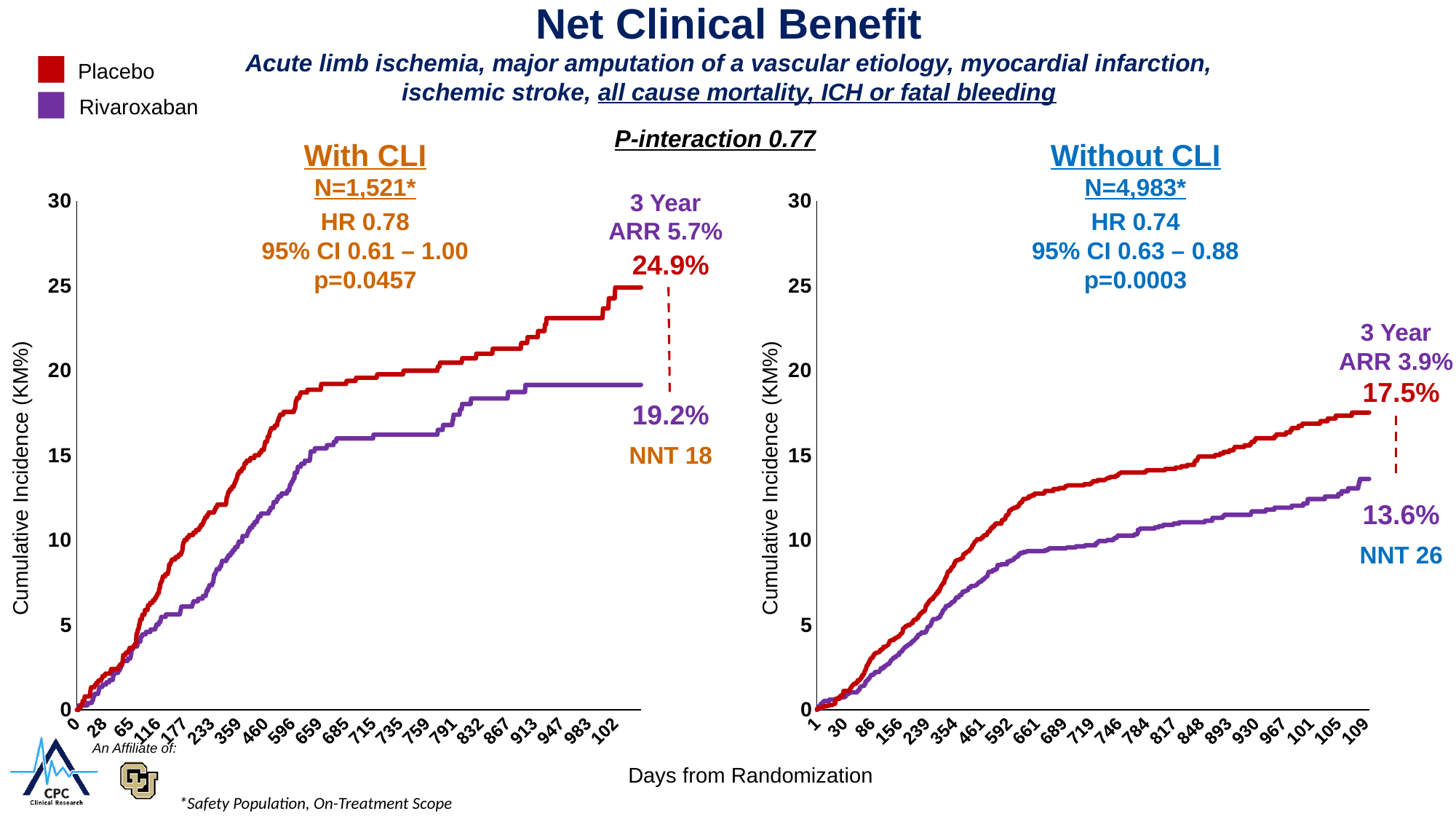
In the 'Without CLI' chart, what is the 3-year cumulative incidence for Placebo? 17.5% In the 'With CLI' chart, what is the 3-year absolute risk reduction (ARR)? 5.7% In the 'Without CLI' chart, does the Placebo curve rise or fall as days from randomization increase? Rise What kind of chart is used on this slide? Line chart In the 'With CLI' chart, what is the 3-year cumulative incidence for Rivaroxaban? 19.2% In the 'With CLI' chart, is the 3-year cumulative incidence for Placebo greater or less than 20? greater In the 'Without CLI' chart, what is the 3-year cumulative incidence for Rivaroxaban? 13.6% In the 'Without CLI' chart, what is the 3-year absolute risk reduction (ARR)? 3.9% In the 'With CLI' chart, which treatment group has the higher 3-year cumulative incidence, Placebo or Rivaroxaban? Placebo In the 'With CLI' chart, what is the 3-year cumulative incidence for Placebo? 24.9% In the 'Without CLI' chart, is the 3-year cumulative incidence for Rivaroxaban greater or less than 15? less How many series does the legend list? 2